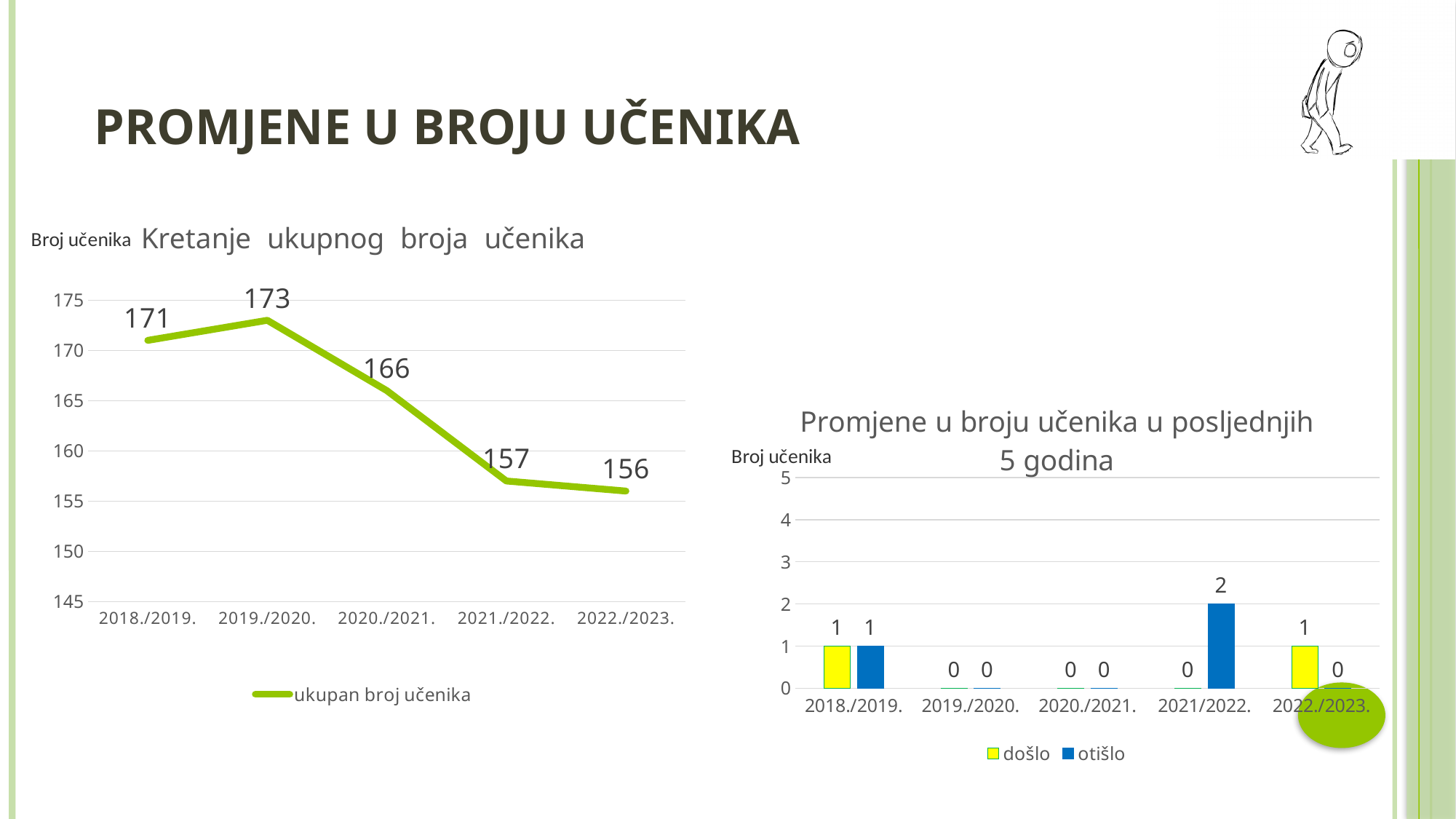
In the chart 'Kretanje ukupnog broja učenika', which school year has the lowest value? 2022./2023. In the chart 'Kretanje ukupnog broja učenika', which school year has the highest value? 2019./2020. In the chart 'Promjene u broju učenika u posljednjih 5 godina', what is the value of 'otišlo' for 2021/2022.? 2 In the chart 'Promjene u broju učenika u posljednjih 5 godina', how many series does the legend list? 2 In the chart 'Kretanje ukupnog broja učenika', what is the difference between the values for 2019./2020. and 2022./2023.? 17 What kind of chart is 'Kretanje ukupnog broja učenika'? line chart In the chart 'Promjene u broju učenika u posljednjih 5 godina', what is the value of 'došlo' for 2022./2023.? 1 In the chart 'Kretanje ukupnog broja učenika', how many data points are plotted? 5 In the chart 'Kretanje ukupnog broja učenika', do the values rise or fall from 2019./2020. to 2022./2023.? fall In the chart 'Promjene u broju učenika u posljednjih 5 godina', which colour represents the 'otišlo' series? blue What kind of chart is 'Promjene u broju učenika u posljednjih 5 godina'? bar chart In the chart 'Kretanje ukupnog broja učenika', what is the value for 2020./2021.? 166